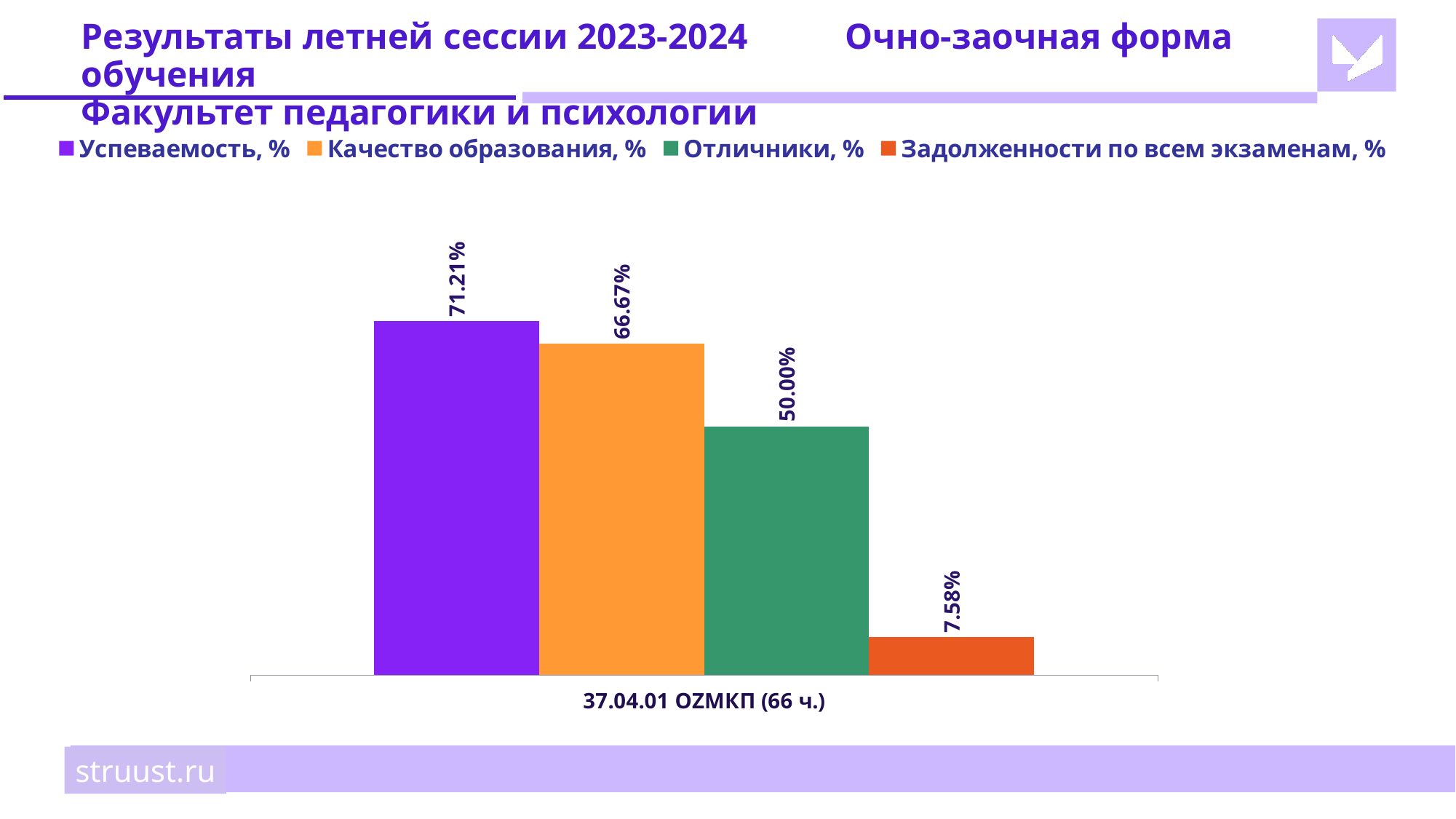
What is the value of Качество образования, % for 37.04.01 OZМКП (66 ч.)? 66.67% What is the value of Отличники, % for 37.04.01 OZМКП (66 ч.)? 50.00% What is the difference between Отличники, % and Задолженности по всем экзаменам, %? 42.42% Which series has the lowest value on the chart? Задолженности по всем экзаменам, % What is the value of Успеваемость, % for 37.04.01 OZМКП (66 ч.)? 71.21% What kind of chart is shown on the slide? Bar chart Which is larger, Качество образования, % or Отличники, %? Качество образования, % What is the value of Задолженности по всем экзаменам, % for 37.04.01 OZМКП (66 ч.)? 7.58% How many series does the legend list? 4 Which series has the highest value on the chart? Успеваемость, % What is the category label shown on the x axis? 37.04.01 OZМКП (66 ч.) What is the difference between Успеваемость, % and Качество образования, %? 4.54%